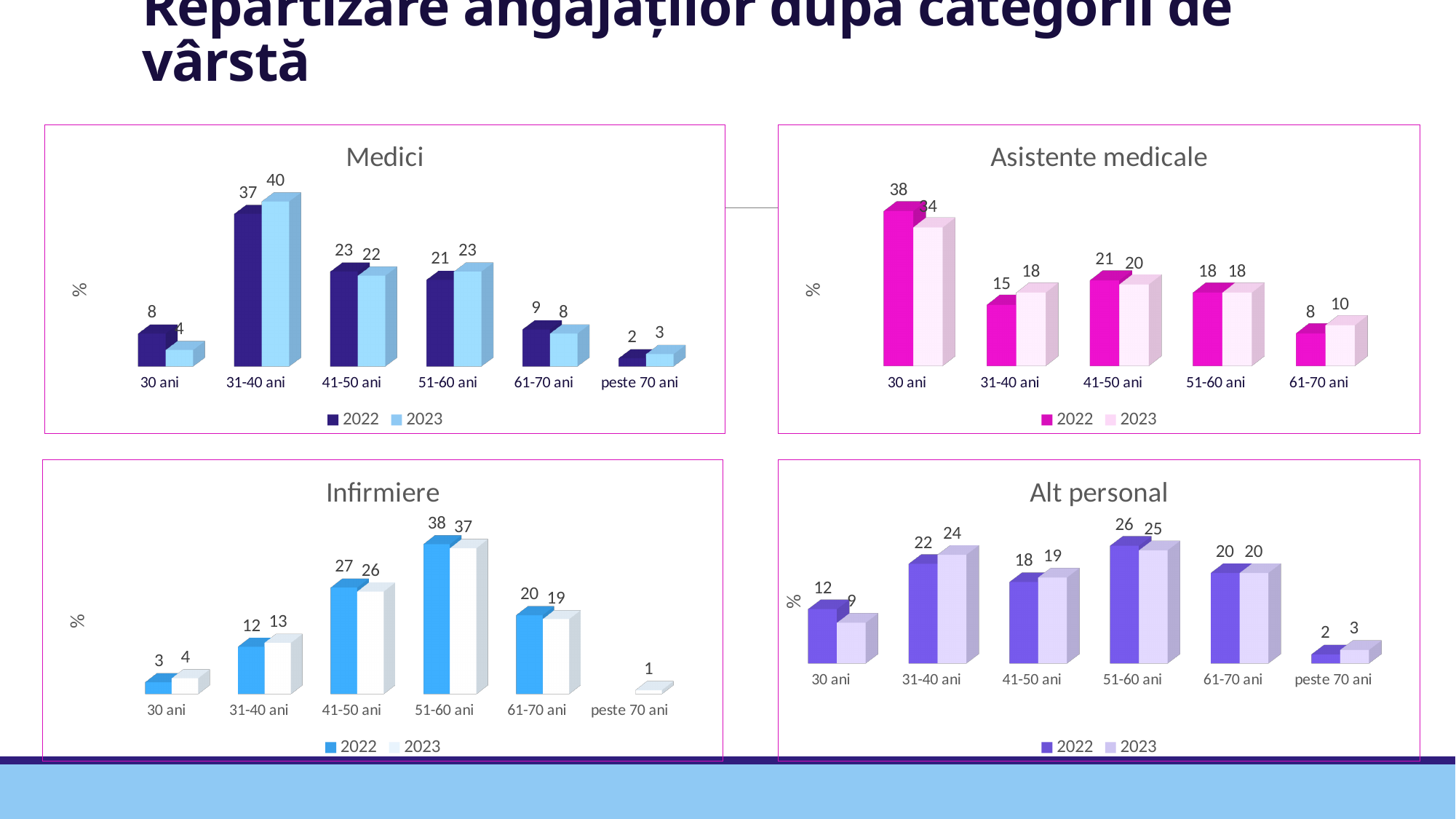
In the Medici chart, which age category has the highest 2022 value? 31-40 ani In the Medici chart, what is the 2023 value for 31-40 ani? 40 In the Asistente medicale chart, how many age categories are shown on the x axis? 5 In the Infirmiere chart, which age category has the lowest 2022 value? 30 ani In the Alt personal chart, what is the difference between the 2022 and 2023 values for 30 ani? 3 In the Medici chart, what is the difference between the 2022 and 2023 values for 30 ani? 4 In the Asistente medicale chart, what is the 2022 value for 30 ani? 38 In the Infirmiere chart, what is the 2022 value for 41-50 ani? 27 How many series does the legend of the Alt personal chart list? 2 In the Asistente medicale chart, which is larger for 31-40 ani: the 2022 value or the 2023 value? 2023 In the Alt personal chart, what is the 2023 value for 31-40 ani? 24 In the Infirmiere chart, which age category has the highest 2023 value? 51-60 ani